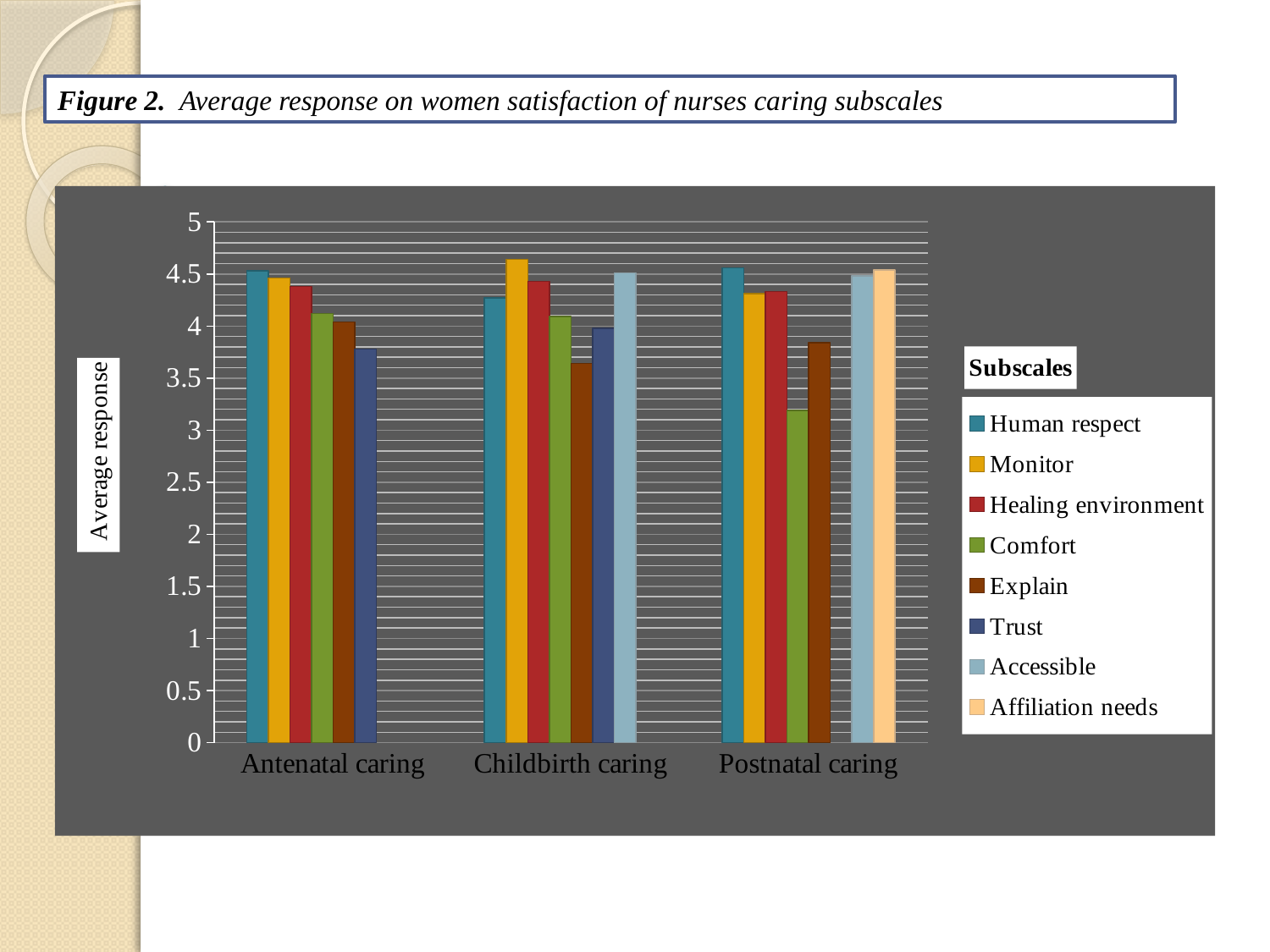
Which subscale has the highest average response in Childbirth caring? Monitor Is the value for Monitor in Childbirth caring greater or less than 4.5? greater How many subscales does the legend list? 8 Is the value for Explain in Childbirth caring greater or less than 4? less Which subscale has the lowest average response in Postnatal caring? Comfort How many caring categories are shown on the x axis? 3 In Childbirth caring, which is larger: Monitor or Human respect? Monitor What is the title of the y axis? Average response What kind of chart is shown on the slide? bar chart Which subscale has the lowest average response in Antenatal caring? Trust Is the value for Comfort in Postnatal caring greater or less than 3.5? less